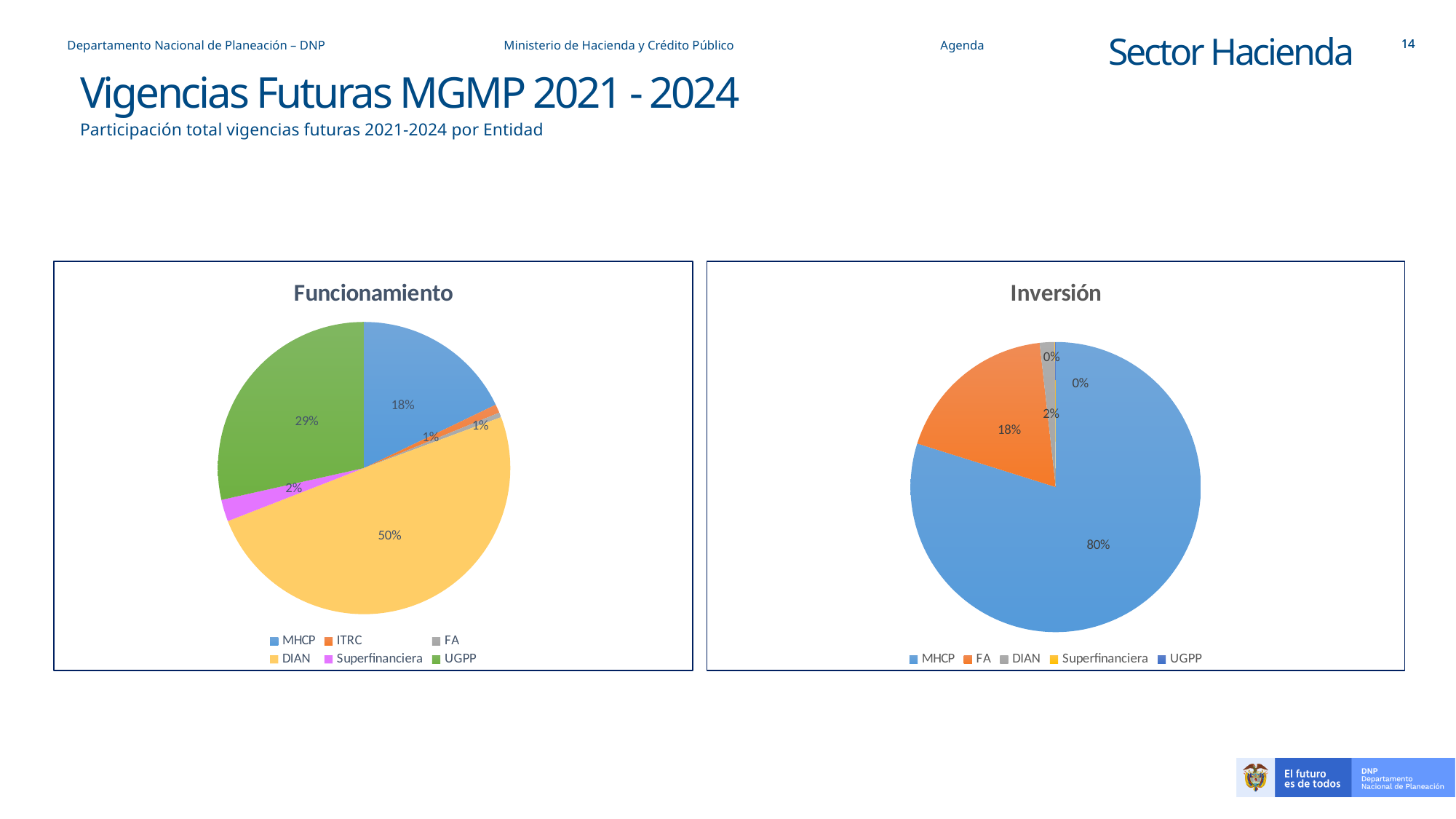
In the Funcionamiento chart, what is the difference between the shares of DIAN and UGPP? 21% In the Inversión chart, what share does FA have? 18% In the Funcionamiento chart, what share does UGPP have? 29% What type of chart is the Funcionamiento chart? Pie chart How many entities does the legend of the Inversión chart list? 5 In the Funcionamiento chart, which entity has the largest share? DIAN In the Funcionamiento chart, what share does Superfinanciera have? 2% In the Inversión chart, what share does DIAN have? 2% In the Inversión chart, which entity has the largest share? MHCP In the Funcionamiento chart, what share does DIAN have? 50% In the Funcionamiento chart, what share does MHCP have? 18% In the Inversión chart, what share does MHCP have? 80%